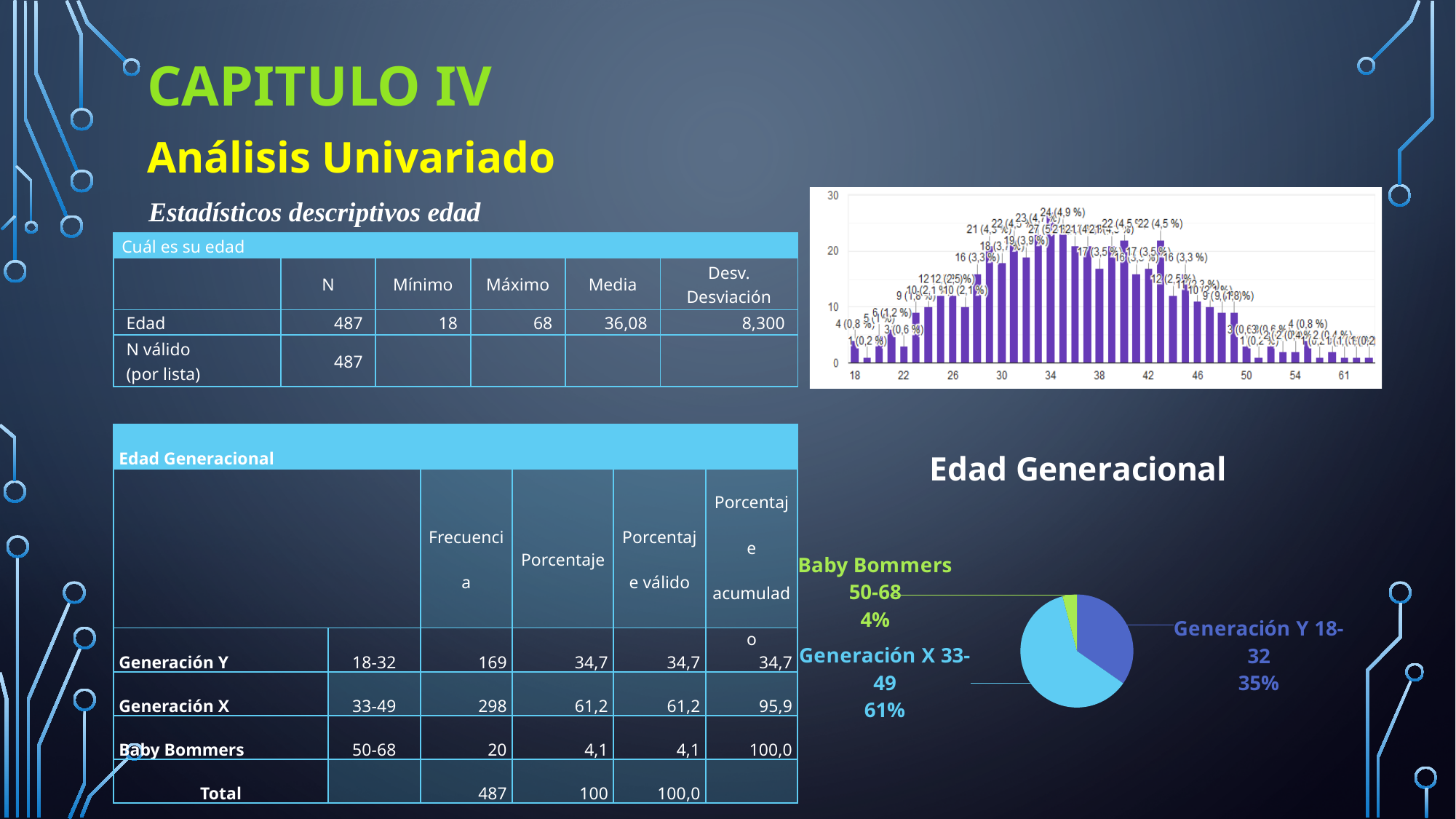
In the bar chart at the top right of the slide, is the value for age 18 greater or less than 10? less In the pie chart titled 'Edad Generacional', what share does Generación X 33-49 have? 61% In the pie chart titled 'Edad Generacional', which slice is the smallest? Baby Bommers 50-68 In the pie chart titled 'Edad Generacional', how many percentage points larger is Generación X 33-49 than Generación Y 18-32? 26 In the pie chart titled 'Edad Generacional', which slice is the largest? Generación X 33-49 In the pie chart titled 'Edad Generacional', how many slices are there? 3 What kind of chart is the chart at the top right of the slide? Bar chart What kind of chart is the chart at the bottom right of the slide? Pie chart In the pie chart titled 'Edad Generacional', what share does Generación Y 18-32 have? 35% In the bar chart at the top right of the slide, is the value for age 34 greater or less than 20? greater In the pie chart titled 'Edad Generacional', what share does Baby Bommers 50-68 have? 4%